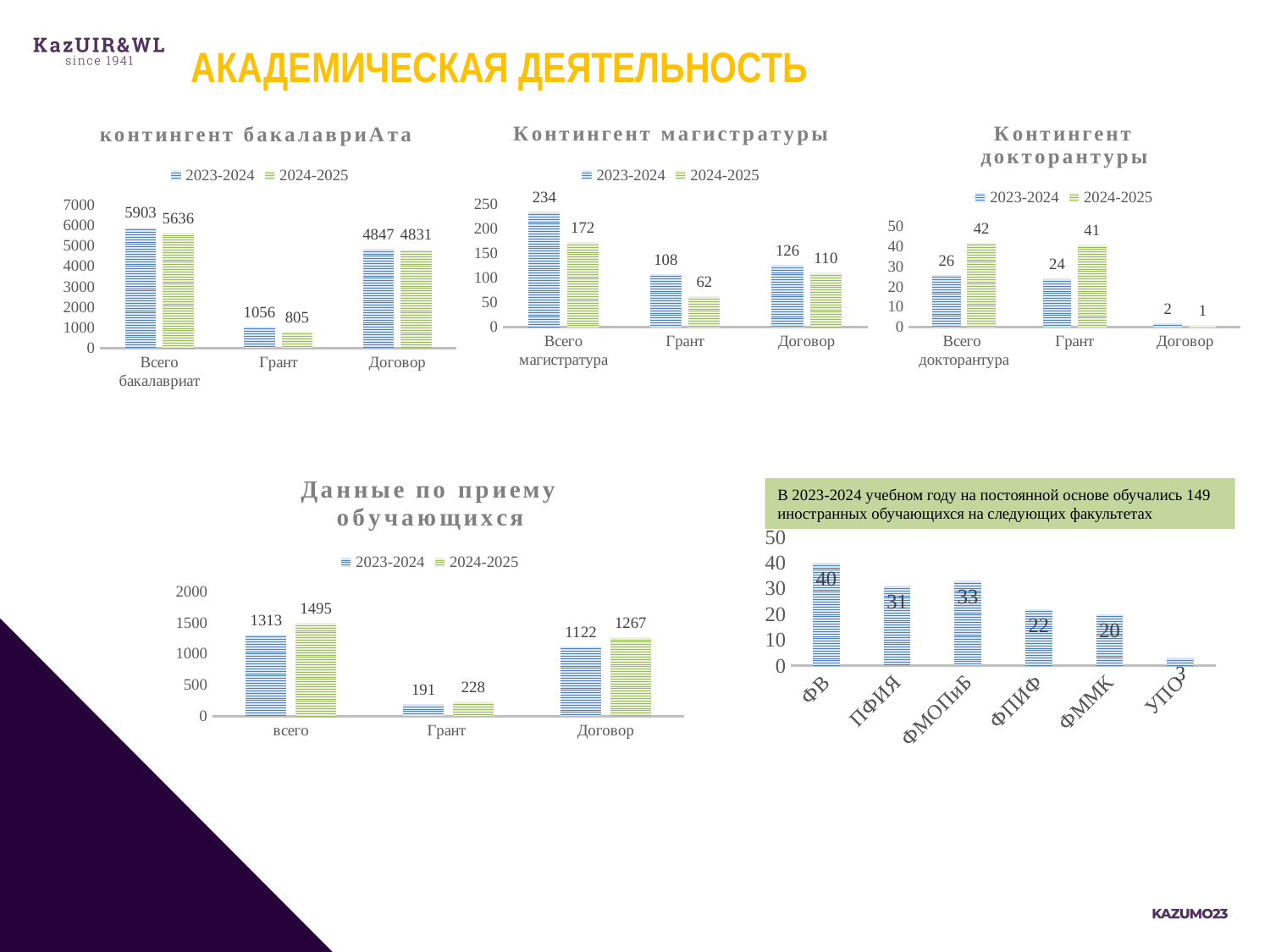
In the 'Контингент докторантуры' chart, what is the value for Грант in 2024-2025? 41 In the 'Данные по приему обучающихся' chart, what is the value for Договор in 2024-2025? 1267 In the 'Контингент магистратуры' chart, what is the value for Грант in 2024-2025? 62 In the 'Данные по приему обучающихся' chart, what is the difference between the 2024-2025 and 2023-2024 values for всего? 182 How many faculties are shown in the bottom-right chart of foreign students? 6 In the bottom-right chart of foreign students by faculty, what is the value for ФМОПиБ? 33 How many series does the legend of the 'Данные по приему обучающихся' chart list? 2 In the 'Контингент докторантуры' chart, which is larger for Всего докторантура: 2023-2024 or 2024-2025? 2024-2025 In the 'контингент бакалавриАта' chart, what is the difference between the 2023-2024 and 2024-2025 values for Грант? 251 In the 'Контингент магистратуры' chart, which category has the highest value for 2023-2024? Всего магистратура In the 'контингент бакалавриАта' chart, what is the value for Всего бакалавриат in 2023-2024? 5903 In the 'Контингент докторантуры' chart, which category has the lowest value for 2024-2025? Договор